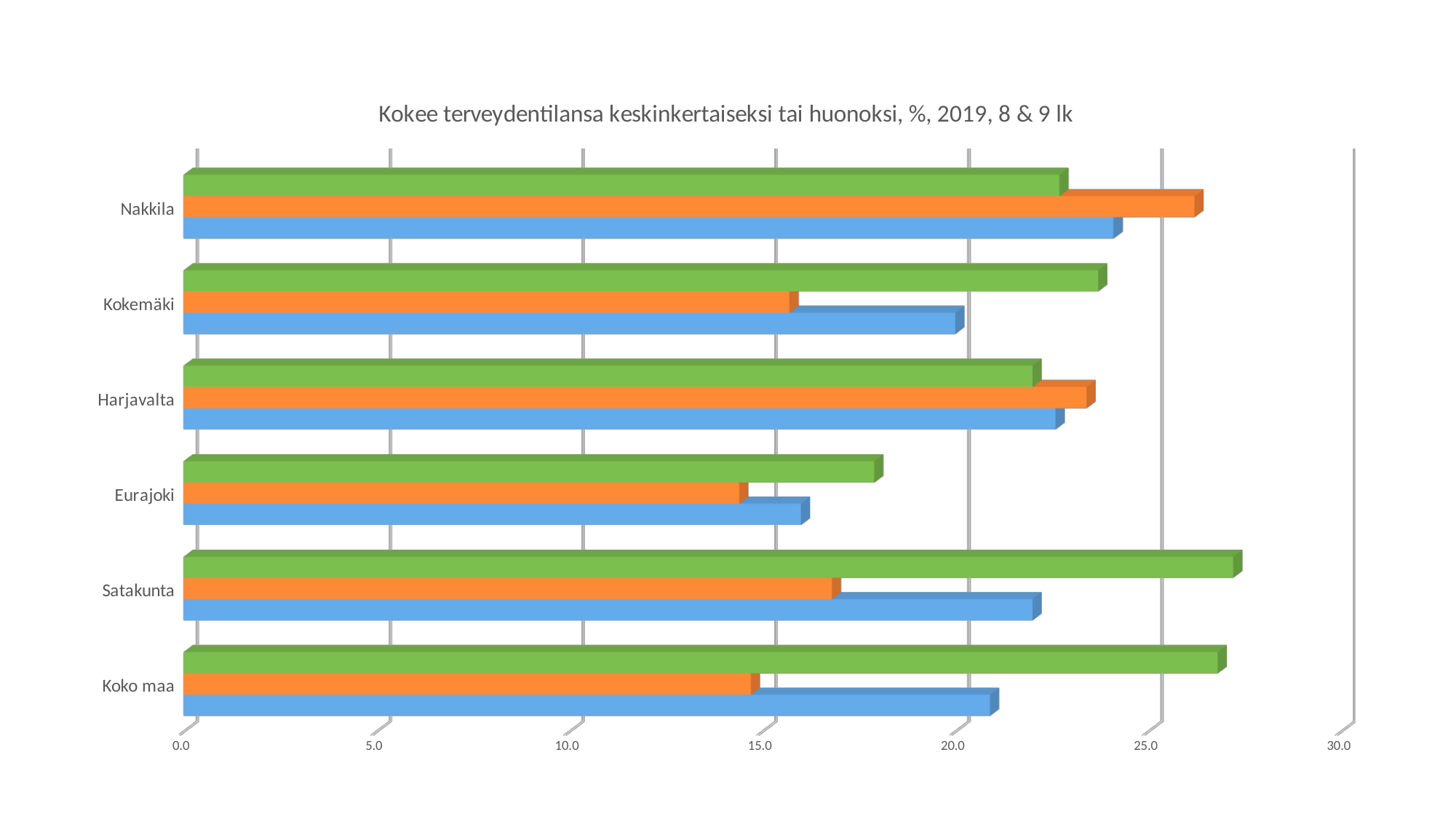
What is the title of the chart? Kokee terveydentilansa keskinkertaiseksi tai huonoksi, %, 2019, 8 & 9 lk Is the orange bar for Harjavalta greater or less than 25? less For Kokemäki, which is larger: the green bar or the orange bar? green bar Is the green bar for Satakunta greater or less than 25? greater Is the green bar for Eurajoki greater or less than 20? less Which category has the lowest green bar? Eurajoki What kind of chart is shown on the slide? bar chart For Nakkila, which is larger: the orange bar or the blue bar? orange bar How many bars are plotted for each category in the chart? 3 Which category has the highest orange bar? Nakkila How many categories are shown on the vertical axis of the chart? 6